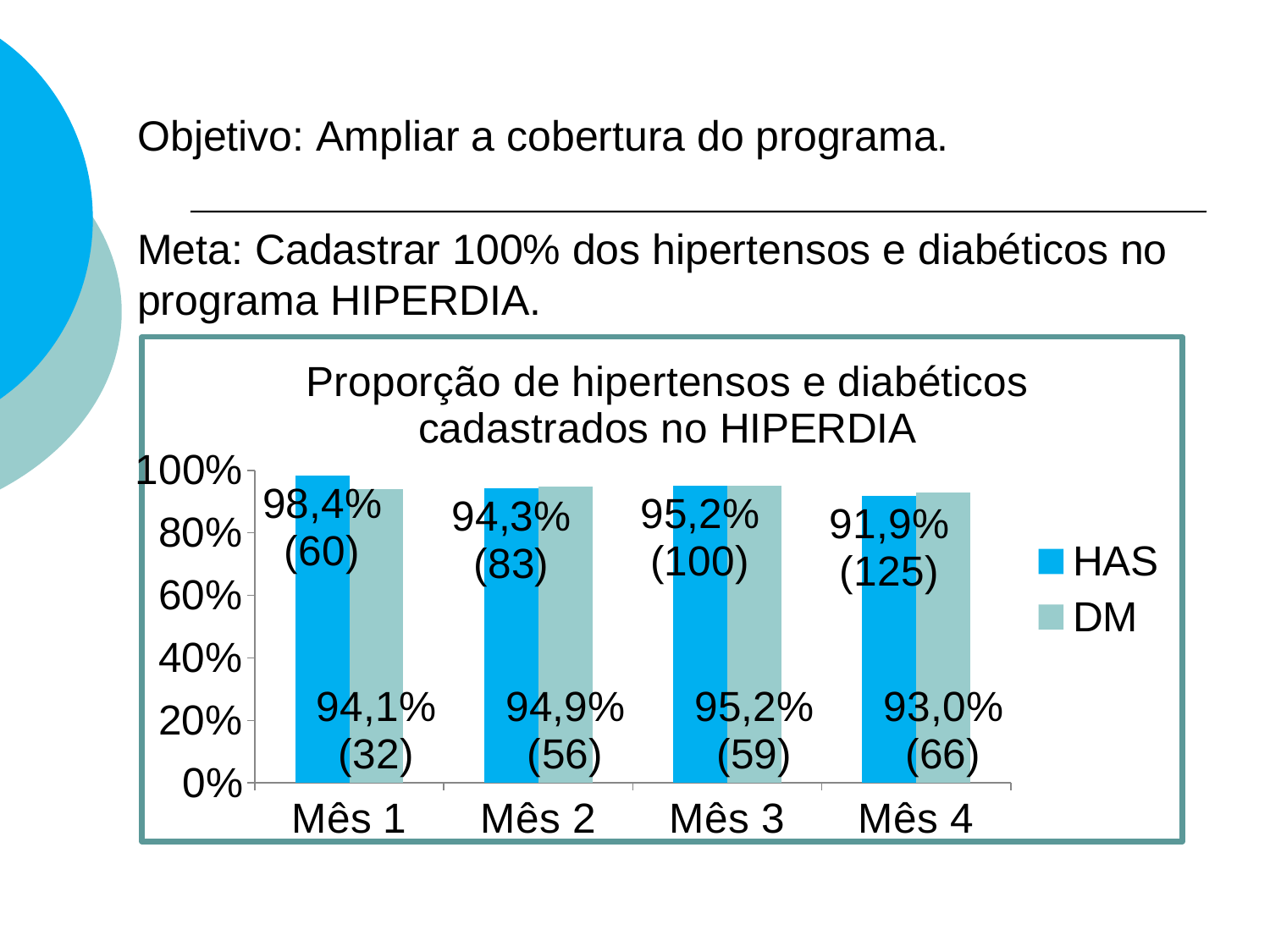
In Mês 1, which series has the larger percentage, HAS or DM? HAS In which month is the HAS percentage lowest? Mês 4 In which month is the DM percentage lowest? Mês 4 How many months (categories) are shown on the x axis? 4 How many series does the legend list? 2 What is the HAS value for Mês 1? 98,4% (60) In which month is the HAS percentage highest? Mês 1 What type of chart is shown on the slide? Bar chart What is the DM value for Mês 2? 94,9% (56) What is the difference in percentage points between the HAS value for Mês 1 and the HAS value for Mês 4? 6,5 percentage points What is the HAS value for Mês 4? 91,9% (125) What is the DM value for Mês 4? 93,0% (66)